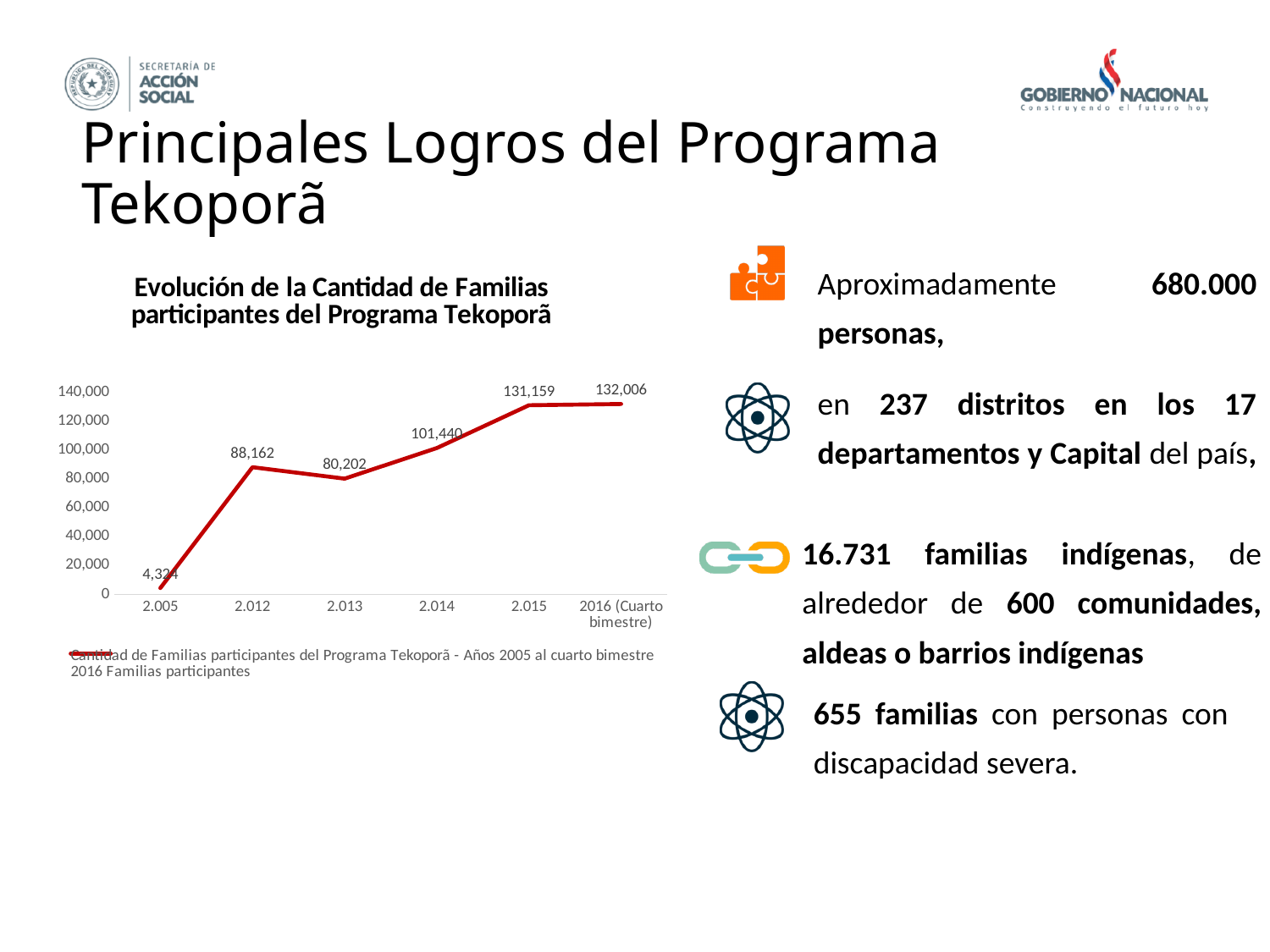
What is the number of participating families in 2.005? 4,324 What is the number of participating families in 2.014? 101,440 What type of chart is shown on the slide? Line chart What is the number of participating families in 2.012? 88,162 Which is larger, the value for 2.012 or the value for 2.013? 2.012 What is the difference between the values for 2.015 and 2.014? 29,719 Which period has the highest number of participating families? 2016 (Cuarto bimestre) What is the number of participating families in 2.013? 80,202 How many data points are plotted on the chart? 6 What is the number of participating families in 2016 (Cuarto bimestre)? 132,006 What is the number of participating families in 2.015? 131,159 Which year has the lowest number of participating families? 2.005